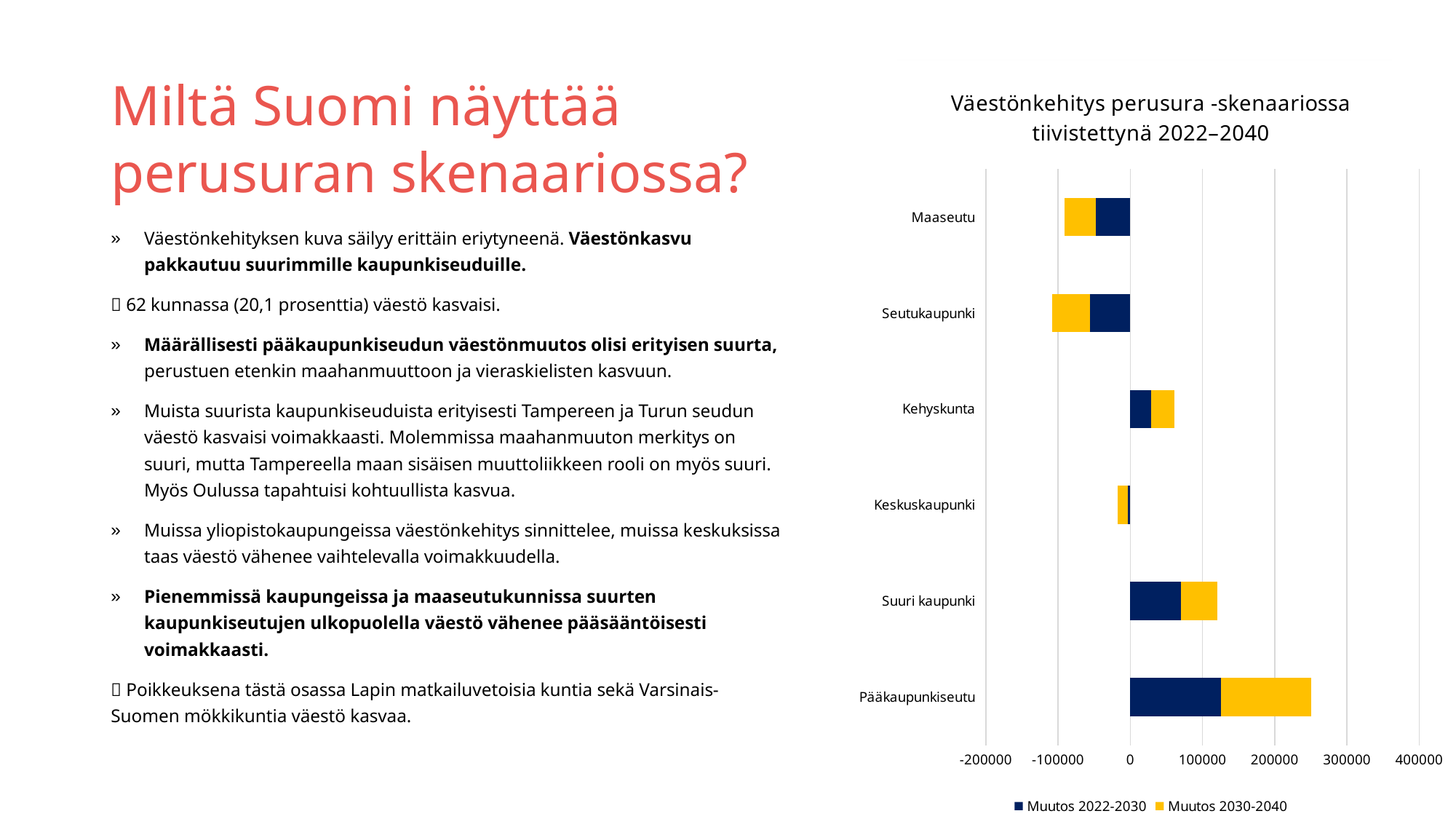
Which series is shown in yellow in the chart? Muutos 2030-2040 Is the Muutos 2022-2030 value for Pääkaupunkiseutu greater or less than 100000? greater Which category has the largest total population change in the chart? Pääkaupunkiseutu Is the total stacked value for Keskuskaupunki greater or less than 0? less How many categories are shown on the chart's vertical axis? 6 What kind of chart is shown on the slide? Bar chart What is the title of the chart? Väestönkehitys perusura -skenaariossa tiivistettynä 2022–2040 Is the Muutos 2022-2030 value for Suuri kaupunki greater or less than 100000? less How many series does the chart legend list? 2 Which category has the most negative total population change in the chart? Seutukaupunki Which has the larger total population change, Suuri kaupunki or Kehyskunta? Suuri kaupunki